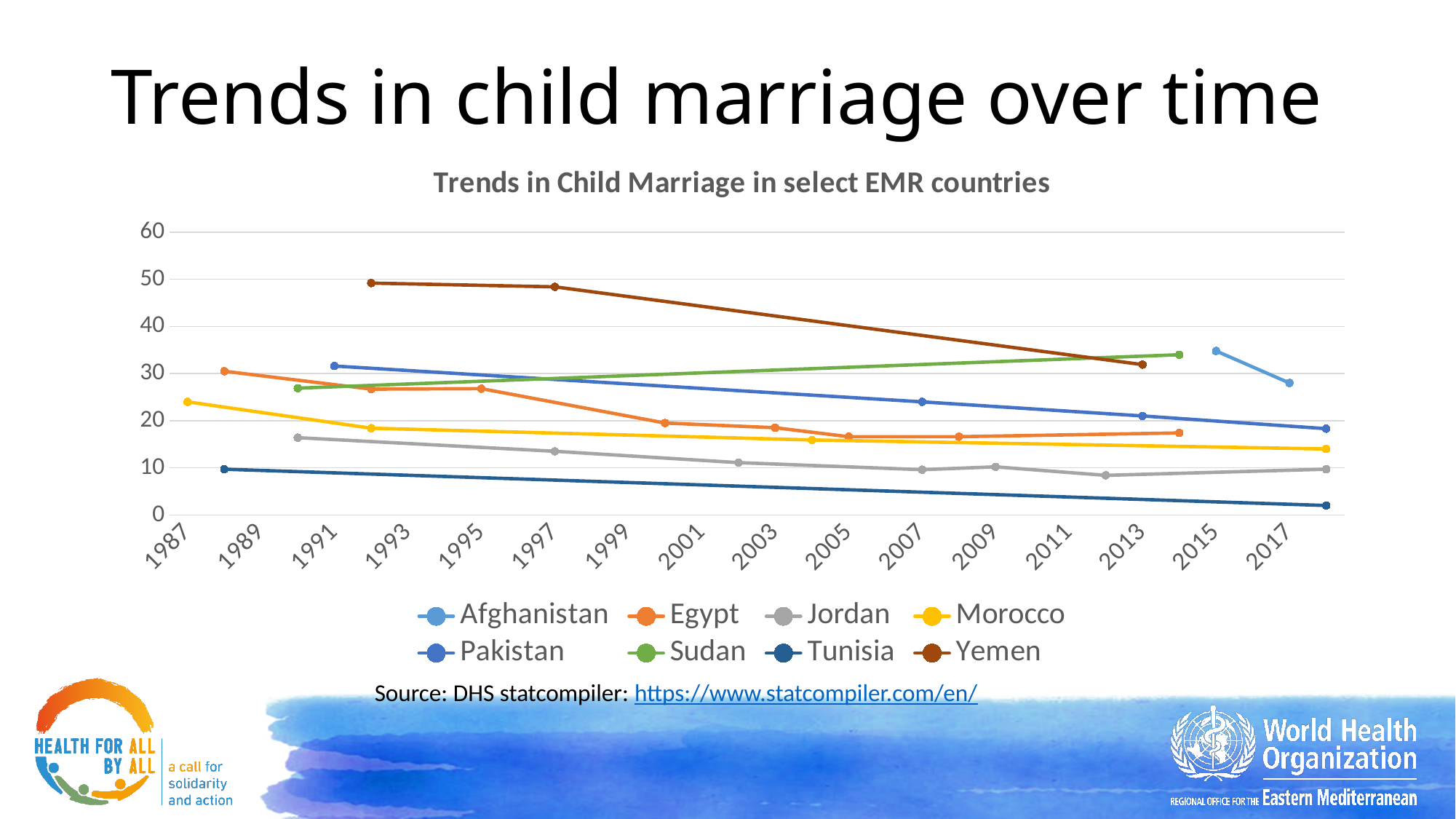
Does the line for Tunisia rise or fall over time? fall Is the value for Yemen in 1992 greater or less than 40? greater Does the line for Egypt rise or fall over time? fall Does the line for Sudan rise or fall over time? rise Is the value for Jordan in 2012 greater or less than 10? less What is the title of the chart? Trends in Child Marriage in select EMR countries Is the value for Tunisia in 2018 greater or less than 10? less What kind of chart is shown on the slide? line chart Which country has the lowest value shown on the chart? Tunisia How many countries does the legend list? 8 Which country has the highest value shown on the chart? Yemen